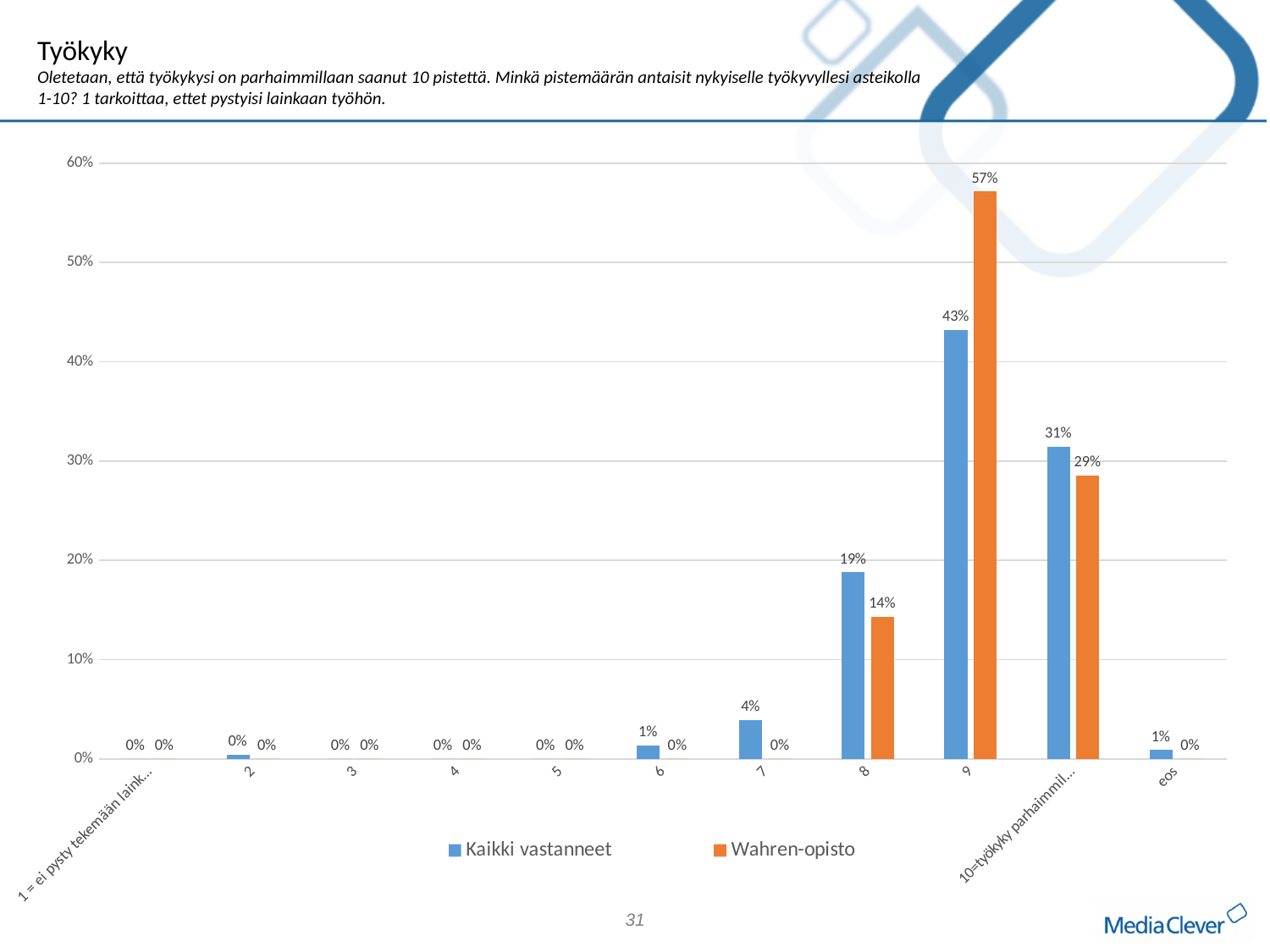
Which category has the highest value for Wahren-opisto? 9 What is the value for Wahren-opisto at category 8? 14% What is the value for Kaikki vastanneet at category eos? 1% What is the value for Kaikki vastanneet at category 9? 43% What is the difference between the Wahren-opisto and Kaikki vastanneet values at category 9? 14% What is the value for Wahren-opisto at category 9? 57% How many categories are shown on the x axis? 11 At category 8, which series has the larger value, Kaikki vastanneet or Wahren-opisto? Kaikki vastanneet What is the value for Kaikki vastanneet at category 7? 4% How many series does the legend list? 2 Is the value for Wahren-opisto at category 9 greater or less than 50%? greater What kind of chart is shown on the slide? bar chart